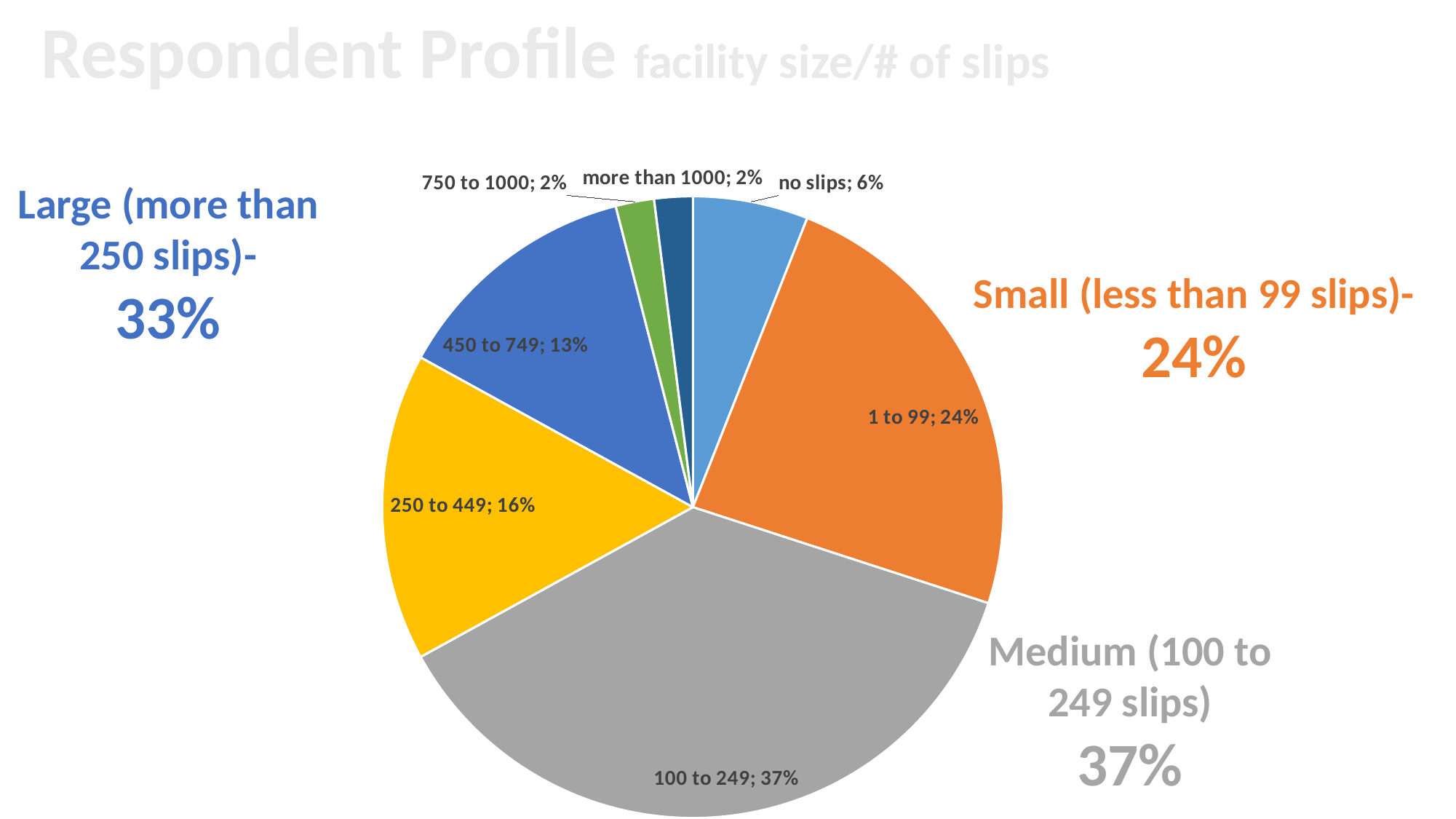
What share of respondents have 100 to 249 slips? 37% What kind of chart is shown on the slide? pie chart What is the difference in share between the 250 to 449 slice and the 450 to 749 slice? 3% How many slices does the pie chart have? 7 What share of respondents have 450 to 749 slips? 13% According to the slide annotation, what percentage of respondents are Large facilities (more than 250 slips)? 33% Which is larger, the share for 1 to 99 slips or the share for 250 to 449 slips? 1 to 99 What share of respondents have no slips? 6% Which facility size category has the largest share of respondents? 100 to 249 What share of respondents have 1 to 99 slips? 24% What share of respondents have more than 1000 slips? 2% What is the title of the slide? Respondent Profile facility size/# of slips